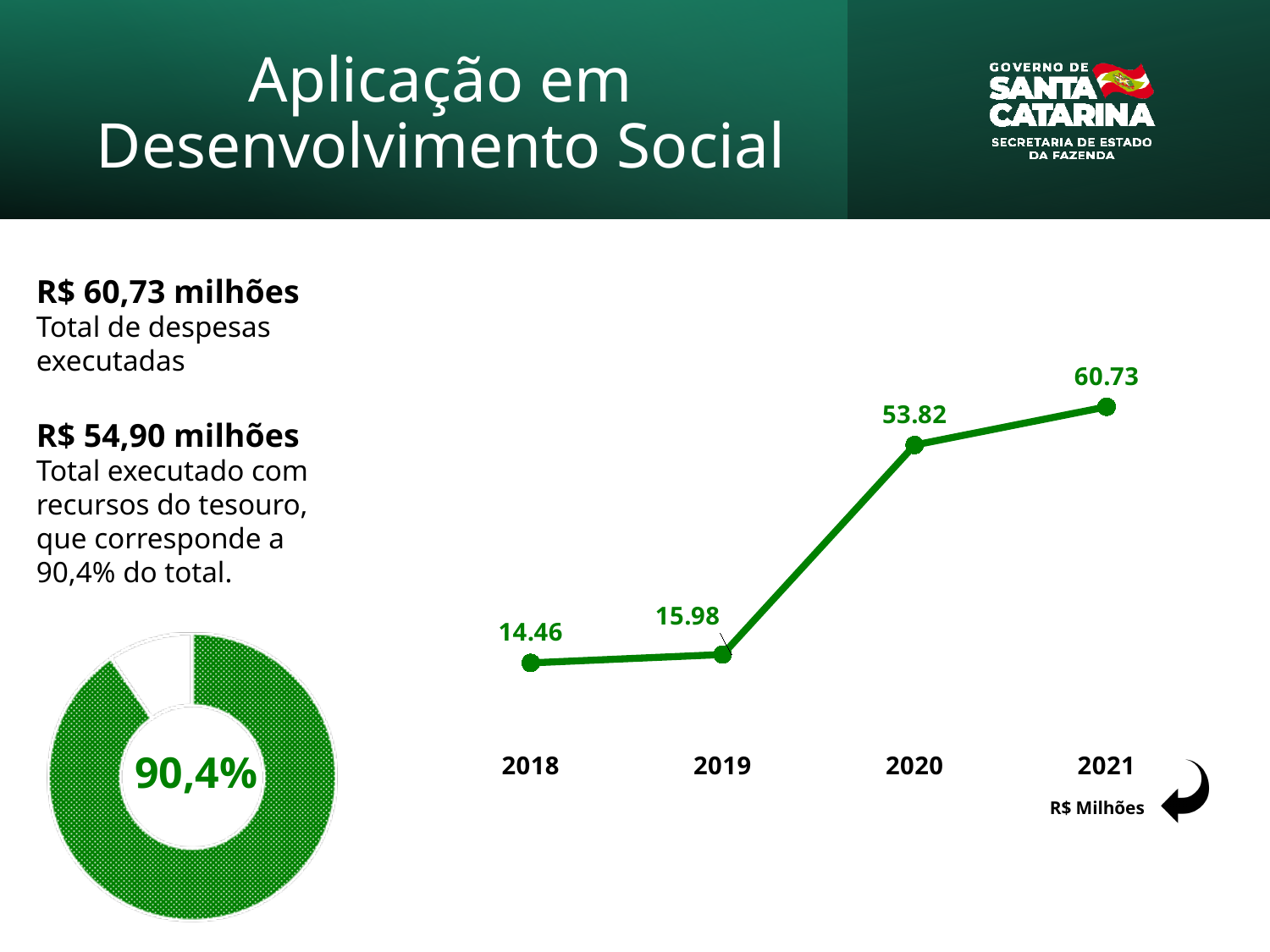
In the line chart, what is the value for 2018? 14.46 In the line chart, what is the value for 2021? 60.73 In the line chart, which year has the lowest value? 2018 In the line chart, what is the value for 2020? 53.82 In the line chart, which year has the highest value? 2021 In the line chart, what is the difference between the values for 2021 and 2018? 46.27 In the line chart, which is larger, the value for 2019 or the value for 2020? 2020 In the line chart, what is the difference between the values for 2020 and 2019? 37.84 In the line chart, do the values rise or fall from 2018 to 2021? rise What kind of chart is the chart on the right of the slide? line chart How many years are plotted in the line chart? 4 What percentage is shown in the centre of the donut chart on the left of the slide? 90,4%